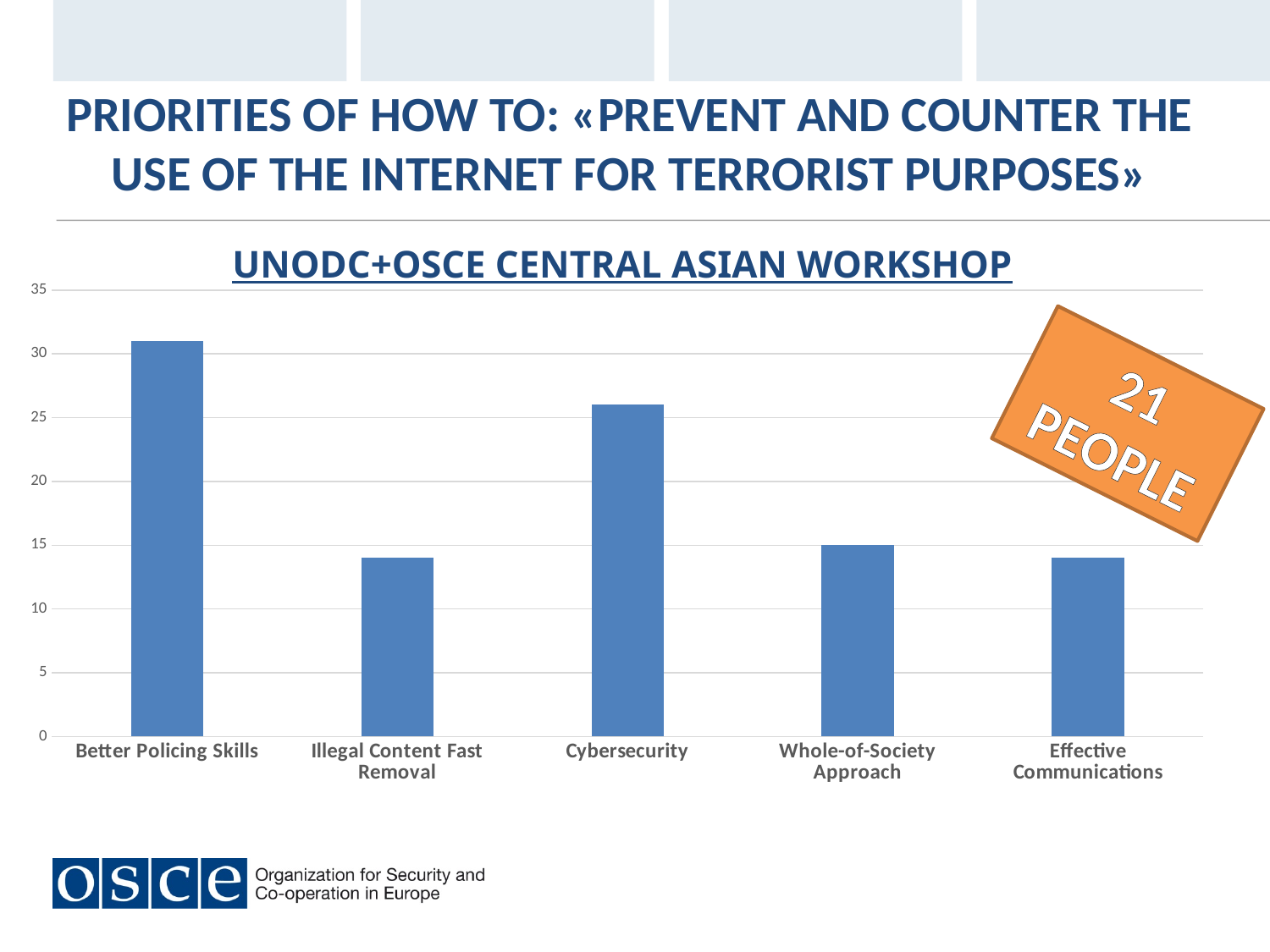
What is the title of the chart? UNODC+OSCE CENTRAL ASIAN WORKSHOP Is the value for Illegal Content Fast Removal greater or less than 20? less What does the orange label on the chart say? 21 PEOPLE What kind of chart is shown on the slide? bar chart Is the value for Effective Communications greater or less than 20? less Is the value for Whole-of-Society Approach greater or less than 10? greater Which is larger, the value for Cybersecurity or the value for Whole-of-Society Approach? Cybersecurity Which is larger, the value for Better Policing Skills or the value for Cybersecurity? Better Policing Skills Which category has the highest bar in the chart? Better Policing Skills How many categories are shown on the x axis of the chart? 5